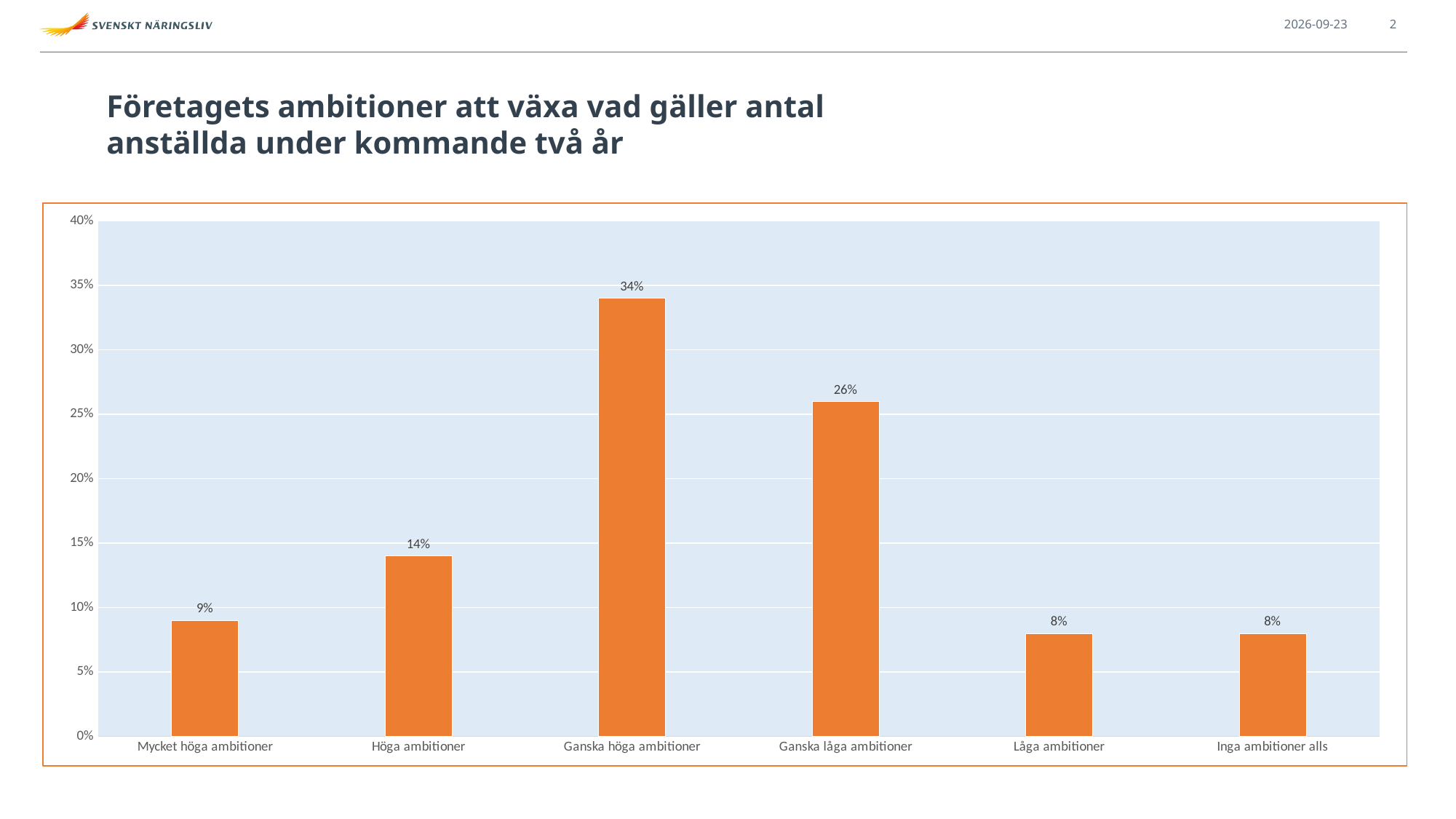
What is the value for Höga ambitioner? 14% What is the difference between Ganska höga ambitioner and Ganska låga ambitioner? 8% Which category has the highest value? Ganska höga ambitioner What is the value for Mycket höga ambitioner? 9% What is the difference between Höga ambitioner and Mycket höga ambitioner? 5% Which is larger, Höga ambitioner or Låga ambitioner? Höga ambitioner What kind of chart is shown on the slide? Bar chart What is the value for Ganska låga ambitioner? 26% How many categories are shown on the x axis? 6 Is the value for Ganska låga ambitioner greater or less than 20%? greater What is the value for Ganska höga ambitioner? 34% What is the title of the slide? Företagets ambitioner att växa vad gäller antal anställda under kommande två år